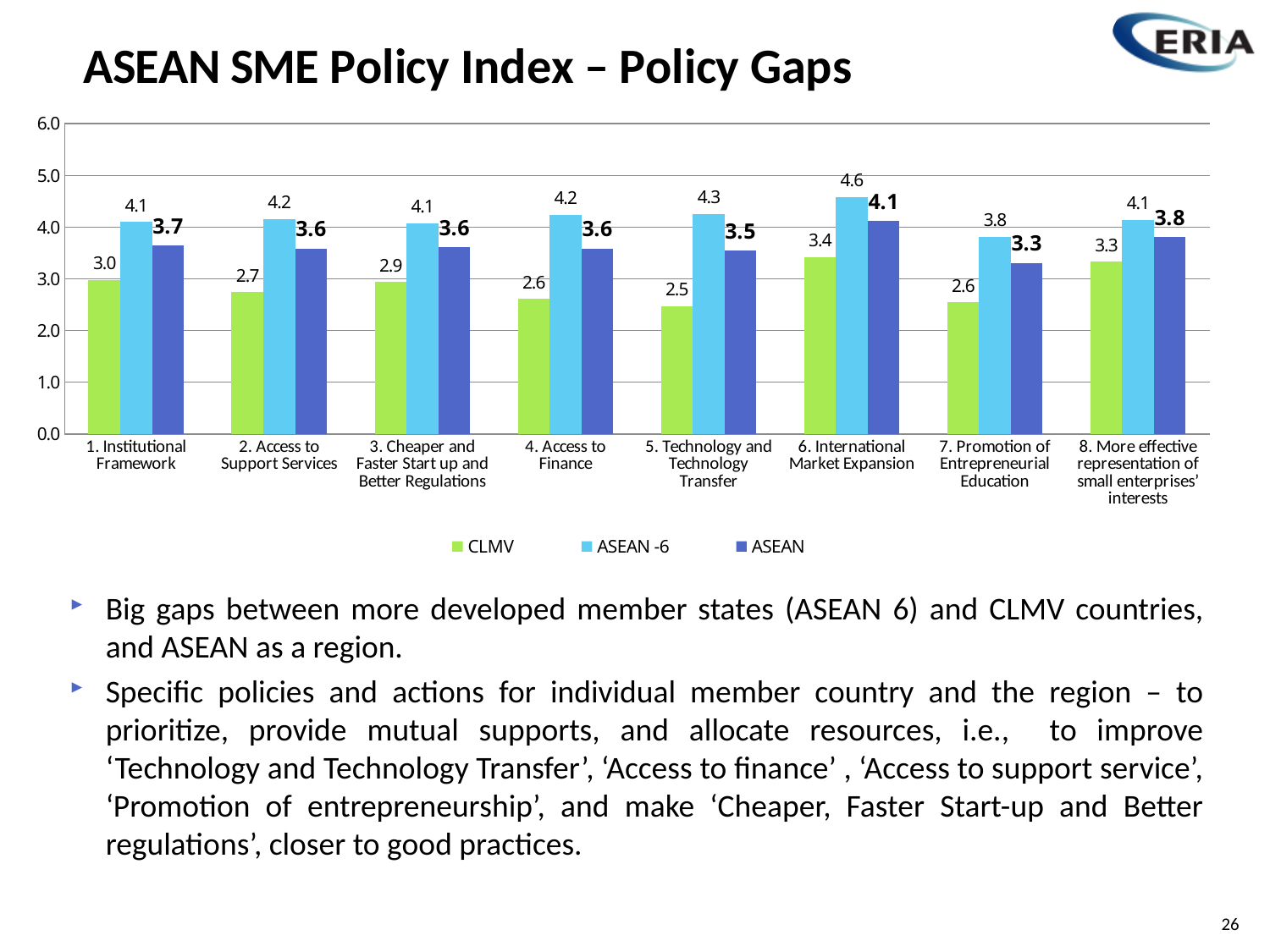
What is the CLMV value for 5. Technology and Technology Transfer? 2.5 Which category has the lowest ASEAN -6 value? 7. Promotion of Entrepreneurial Education Which category has the highest CLMV value? 6. International Market Expansion What is the difference between the ASEAN -6 and CLMV values for 5. Technology and Technology Transfer? 1.8 What is the title of the slide containing the chart? ASEAN SME Policy Index – Policy Gaps What is the ASEAN value for 7. Promotion of Entrepreneurial Education? 3.3 What is the ASEAN -6 value for 6. International Market Expansion? 4.6 What kind of chart is shown on the slide? bar chart Is the ASEAN -6 value for 6. International Market Expansion greater or less than 5.0? less How many series does the legend list? 3 Which is larger for 8. More effective representation of small enterprises' interests: the CLMV value or the ASEAN value? ASEAN How many categories are shown on the x axis? 8